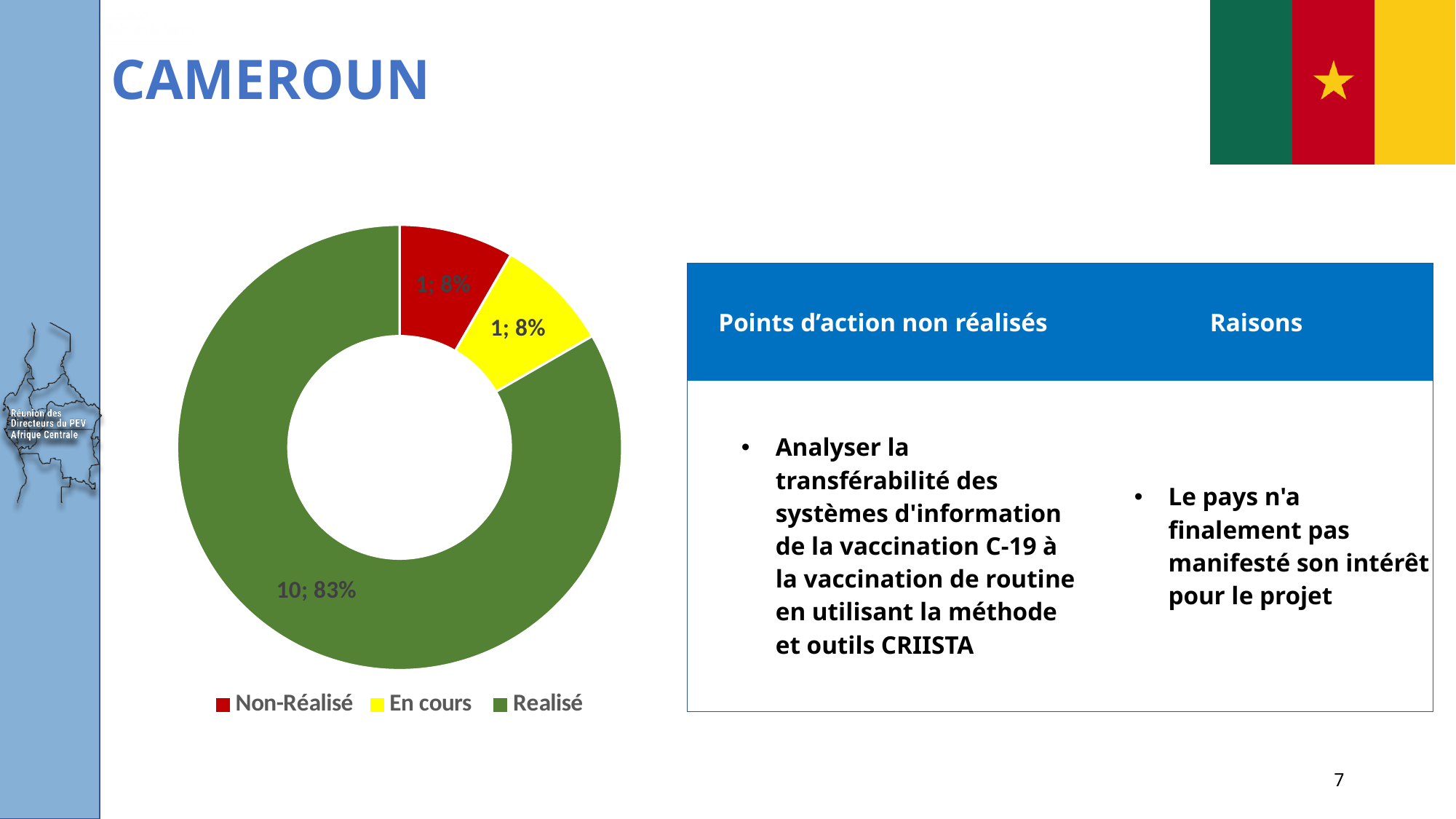
How many categories does the chart's legend list? 3 Which colour represents En cours in the chart? Yellow Which colour represents Non-Réalisé in the chart? Red What is the total of all the values shown in the chart? 12 What percentage share does the Non-Réalisé slice have? 8% Which is larger, the value for Realisé or the value for En cours? Realisé What kind of chart is shown on the slide? Doughnut chart What is the value shown for En cours? 1 What is the value shown for Realisé? 10 What is the difference between the value for Realisé and the value for Non-Réalisé? 9 What percentage share does the Realisé slice have? 83% Which category has the largest slice? Realisé